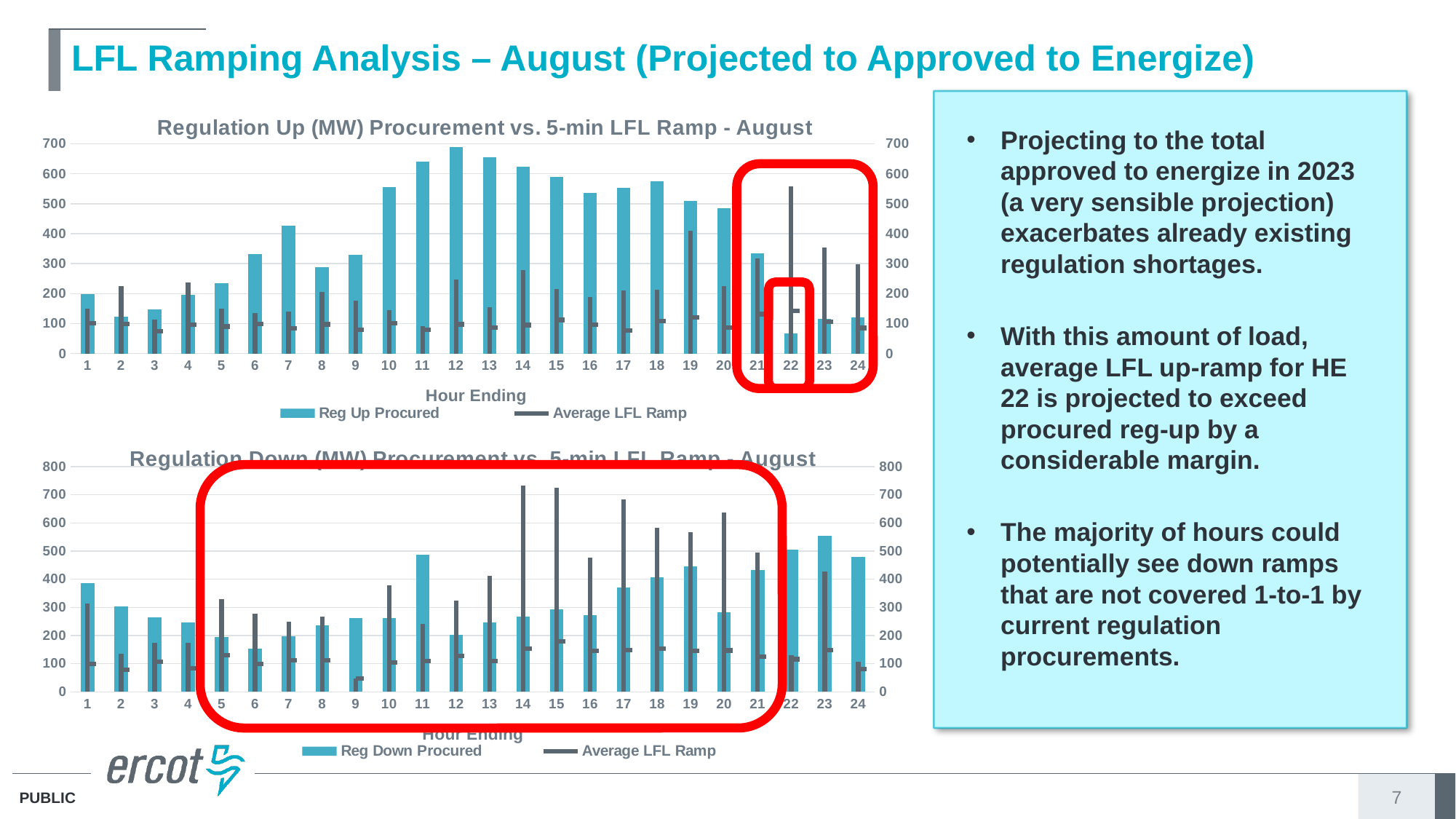
What kind of chart is the top chart, 'Regulation Up (MW) Procurement vs. 5-min LFL Ramp - August'? bar chart In the bottom chart, 'Regulation Down (MW) Procurement vs. 5-min LFL Ramp - August', which hour ending has the lowest Reg Down Procured value? 6 In the bottom chart, 'Regulation Down (MW) Procurement vs. 5-min LFL Ramp - August', which is larger for hour ending 22: Reg Down Procured or Average LFL Ramp? Reg Down Procured In the top chart, 'Regulation Up (MW) Procurement vs. 5-min LFL Ramp - August', is the Reg Up Procured value for hour ending 22 greater or less than 100? less In the top chart, 'Regulation Up (MW) Procurement vs. 5-min LFL Ramp - August', which hour ending has the lowest Reg Up Procured value? 22 What is the x-axis title of the top chart, 'Regulation Up (MW) Procurement vs. 5-min LFL Ramp - August'? Hour Ending In the top chart, 'Regulation Up (MW) Procurement vs. 5-min LFL Ramp - August', which hour ending has the highest Reg Up Procured value? 12 How many series does the legend of the bottom chart, 'Regulation Down (MW) Procurement vs. 5-min LFL Ramp - August', list? 2 In the top chart, 'Regulation Up (MW) Procurement vs. 5-min LFL Ramp - August', is the Reg Up Procured value for hour ending 12 greater or less than 600? greater In the bottom chart, 'Regulation Down (MW) Procurement vs. 5-min LFL Ramp - August', which hour ending has the highest Reg Down Procured value? 23 In the bottom chart, 'Regulation Down (MW) Procurement vs. 5-min LFL Ramp - August', is the Average LFL Ramp value for hour ending 14 greater or less than 600? less How many hour-ending categories are shown on the x axis of the top chart, 'Regulation Up (MW) Procurement vs. 5-min LFL Ramp - August'? 24